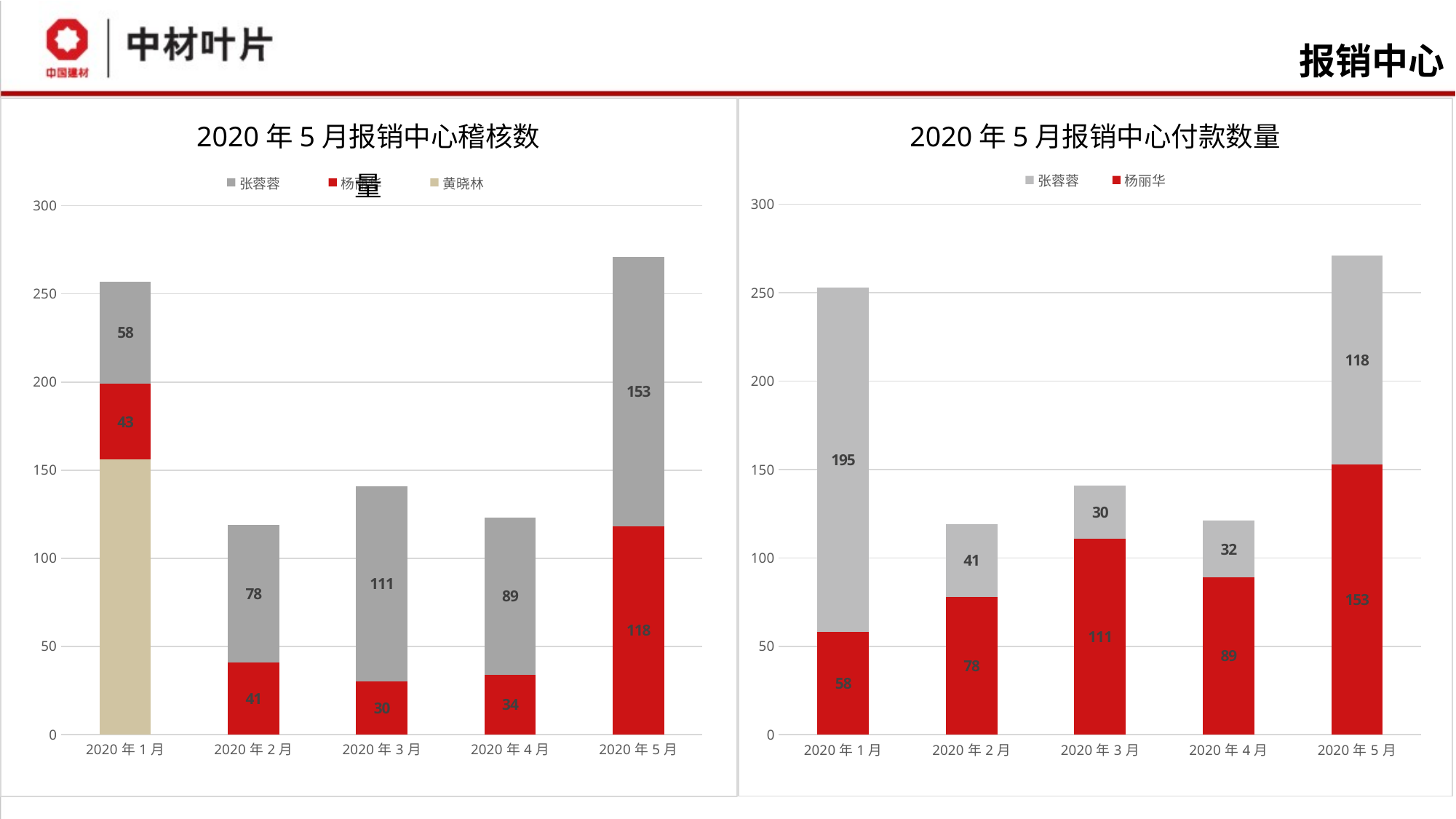
In the left chart, what is the value for 张蓉蓉 in 2020年3月? 111 What kind of chart is the right chart (2020年5月报销中心付款数量)? Stacked bar chart In the right chart (2020年5月报销中心付款数量), what is the difference between the 杨丽华 values for 2020年5月 and 2020年1月? 95 In the right chart (2020年5月报销中心付款数量), what is the total of the stacked bar for 2020年2月? 119 How many months are shown on the x axis of the left chart? 5 How many series does the legend of the left chart list? 3 In the right chart (2020年5月报销中心付款数量), which is larger in 2020年3月, the value for 张蓉蓉 or for 杨丽华? 杨丽华 In the right chart (2020年5月报销中心付款数量), what is the value for 杨丽华 in 2020年5月? 153 In the right chart (2020年5月报销中心付款数量), what is the value for 张蓉蓉 in 2020年1月? 195 In the right chart (2020年5月报销中心付款数量), which month has the highest value for 张蓉蓉? 2020年1月 In the left chart, what is the total of the stacked bar for 2020年5月? 271 In the left chart, which month has the lowest value for 张蓉蓉? 2020年1月